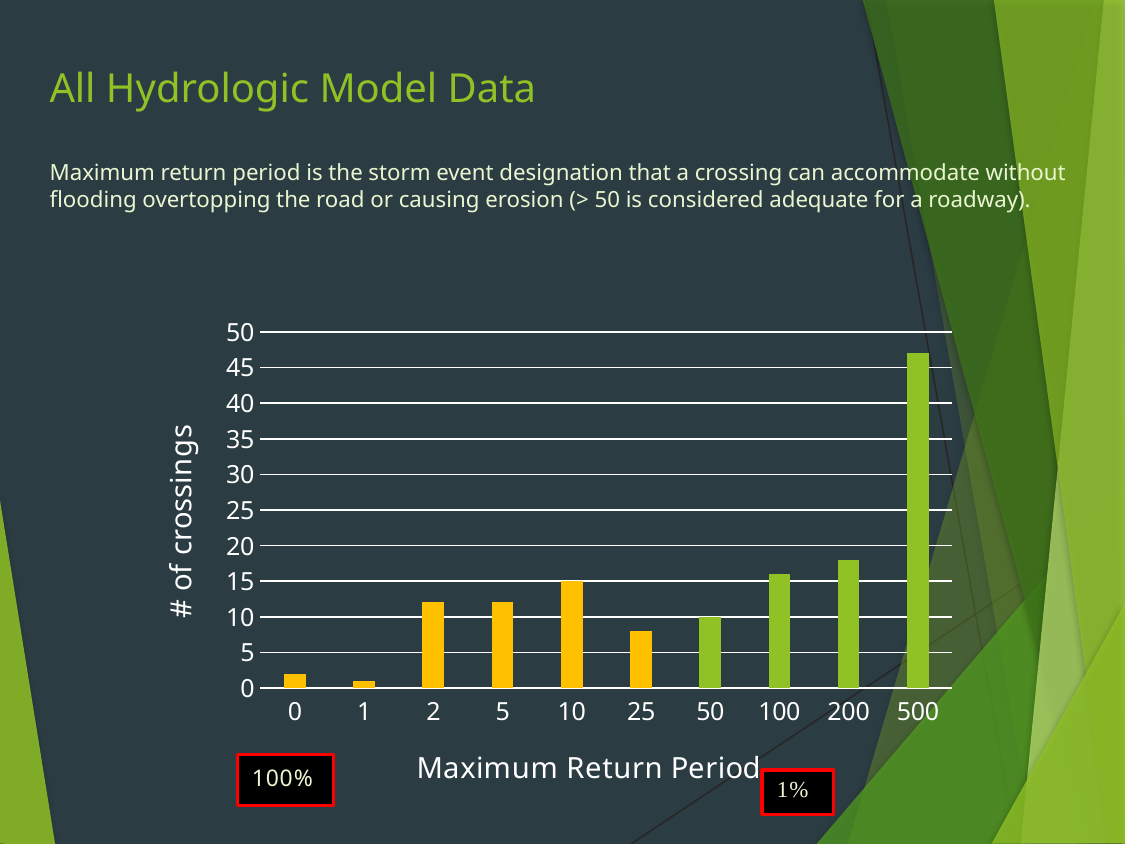
How many maximum return period categories are shown on the x axis? 10 What kind of chart is shown on the slide? bar chart Which maximum return period has the highest number of crossings? 500 Is the number of crossings for a maximum return period of 2 greater or less than 10? greater Which maximum return period has the lowest number of crossings? 1 Which has more crossings: a maximum return period of 10 or 25? 10 Is the number of crossings for a maximum return period of 500 greater or less than 40? greater What is the label of the x axis? Maximum Return Period Which has more crossings: a maximum return period of 200 or 500? 500 What is the label of the y axis? # of crossings Is the number of crossings for a maximum return period of 25 greater or less than 10? less